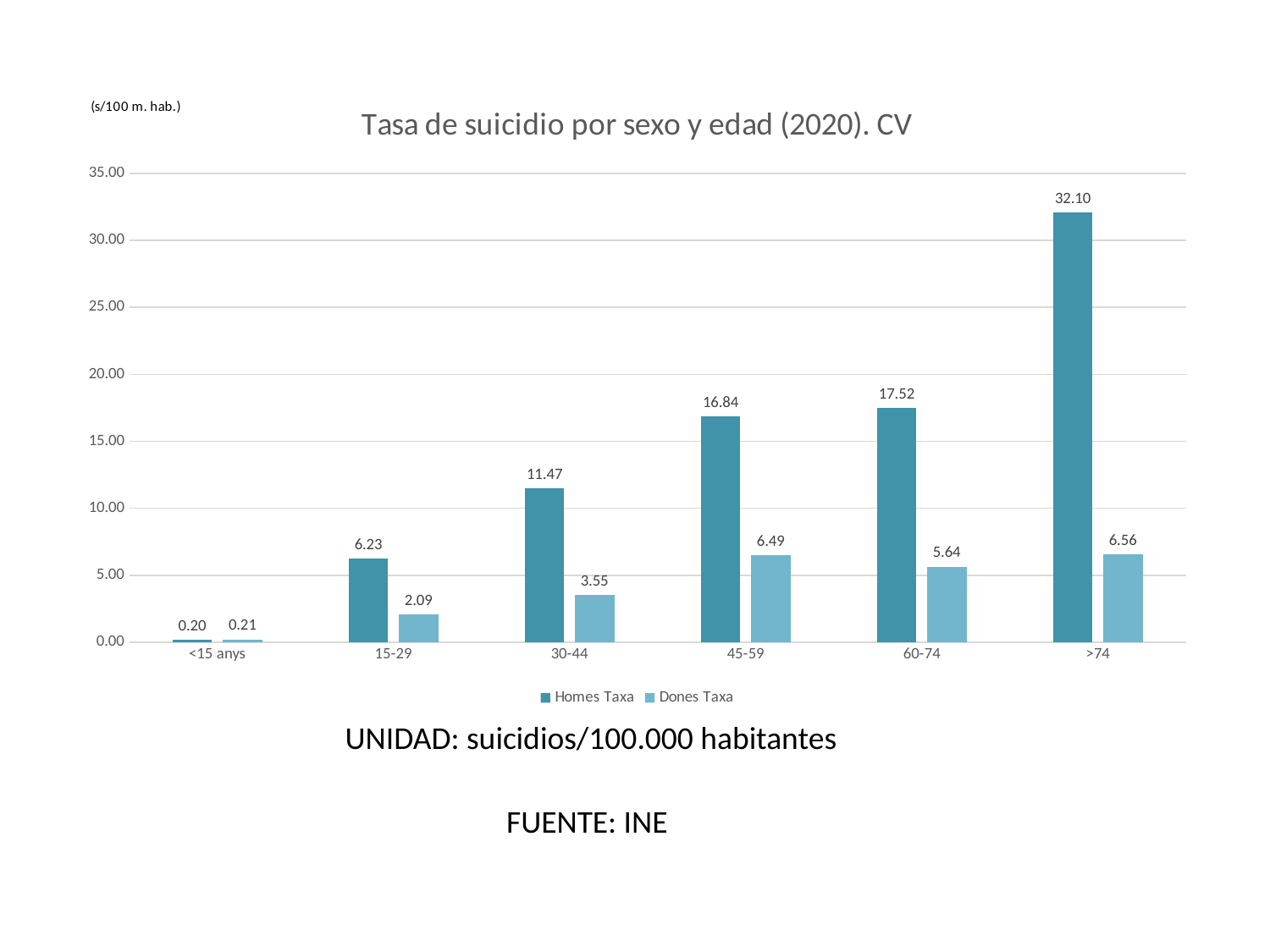
What is the difference between the Homes Taxa and Dones Taxa values for the 60-74 age group? 11.88 Which age group has the lowest Dones Taxa value? <15 anys How many series does the legend list? 2 Which is larger for the 15-29 age group, Homes Taxa or Dones Taxa? Homes Taxa What kind of chart is shown on the slide? Bar chart Do the Homes Taxa values rise or fall as age increases along the x axis? Rise Which age group has the highest Homes Taxa value? >74 What is the Homes Taxa value for the 45-59 age group? 16.84 What is the title of the chart? Tasa de suicidio por sexo y edad (2020). CV What is the Dones Taxa value for the 30-44 age group? 3.55 How many age groups are shown on the x axis? 6 What is the Homes Taxa value for the >74 age group? 32.10